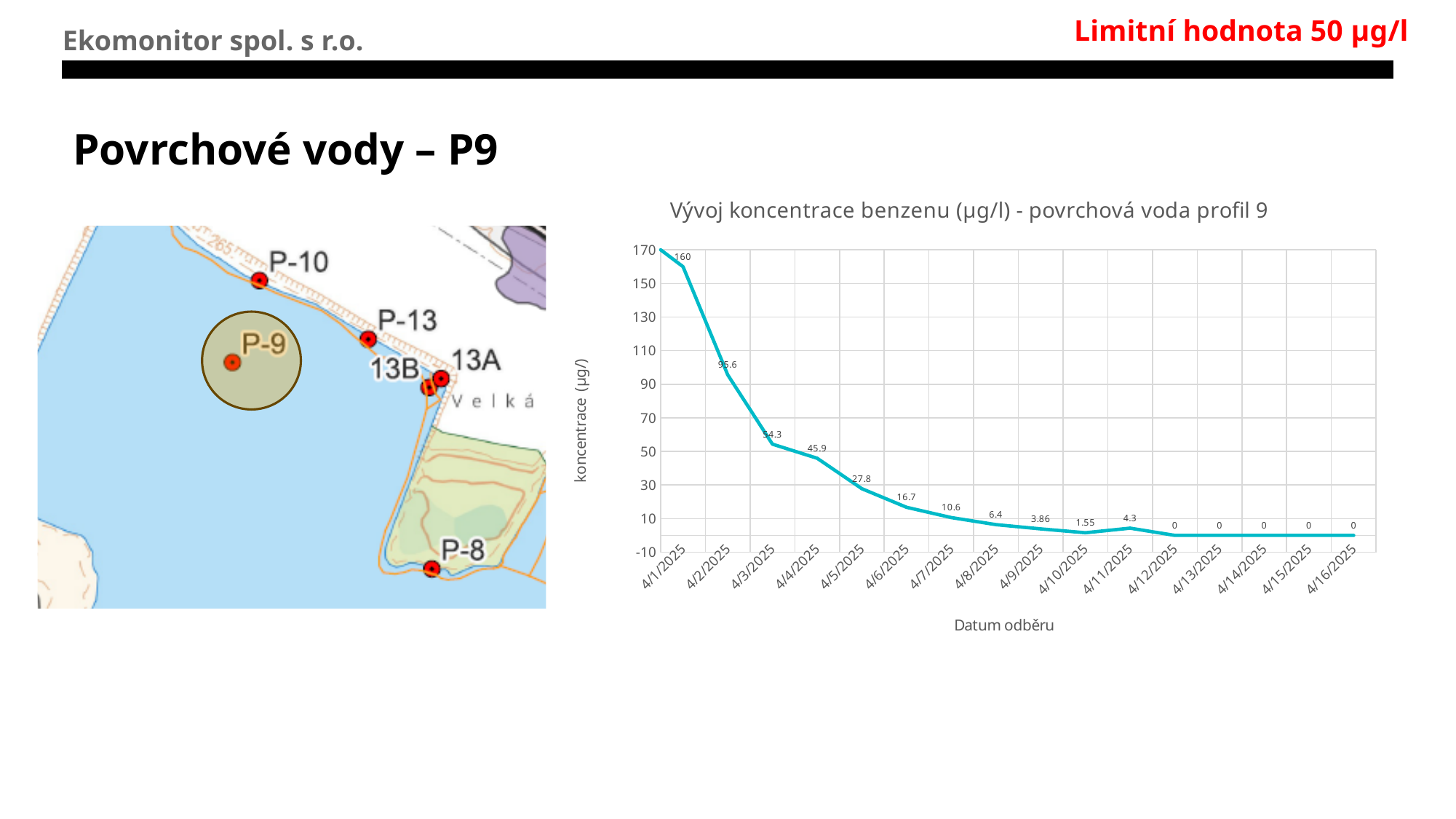
What is the benzene concentration on 4/3/2025? 54.3 What is the title of the chart? Vývoj koncentrace benzenu (µg/l) - povrchová voda profil 9 What is the difference between the concentrations on 4/2/2025 and 4/3/2025? 41.3 Does the benzene concentration generally rise or fall over the dates shown? fall What is the benzene concentration on 4/11/2025? 4.3 What is the benzene concentration on 4/2/2025? 95.6 What is the benzene concentration on 4/9/2025? 3.86 Which date has the larger concentration, 4/4/2025 or 4/6/2025? 4/4/2025 How many dates are plotted on the x axis? 16 What type of chart is shown on the slide? line chart What is the benzene concentration on 4/5/2025? 27.8 On which date is the benzene concentration highest? 4/1/2025